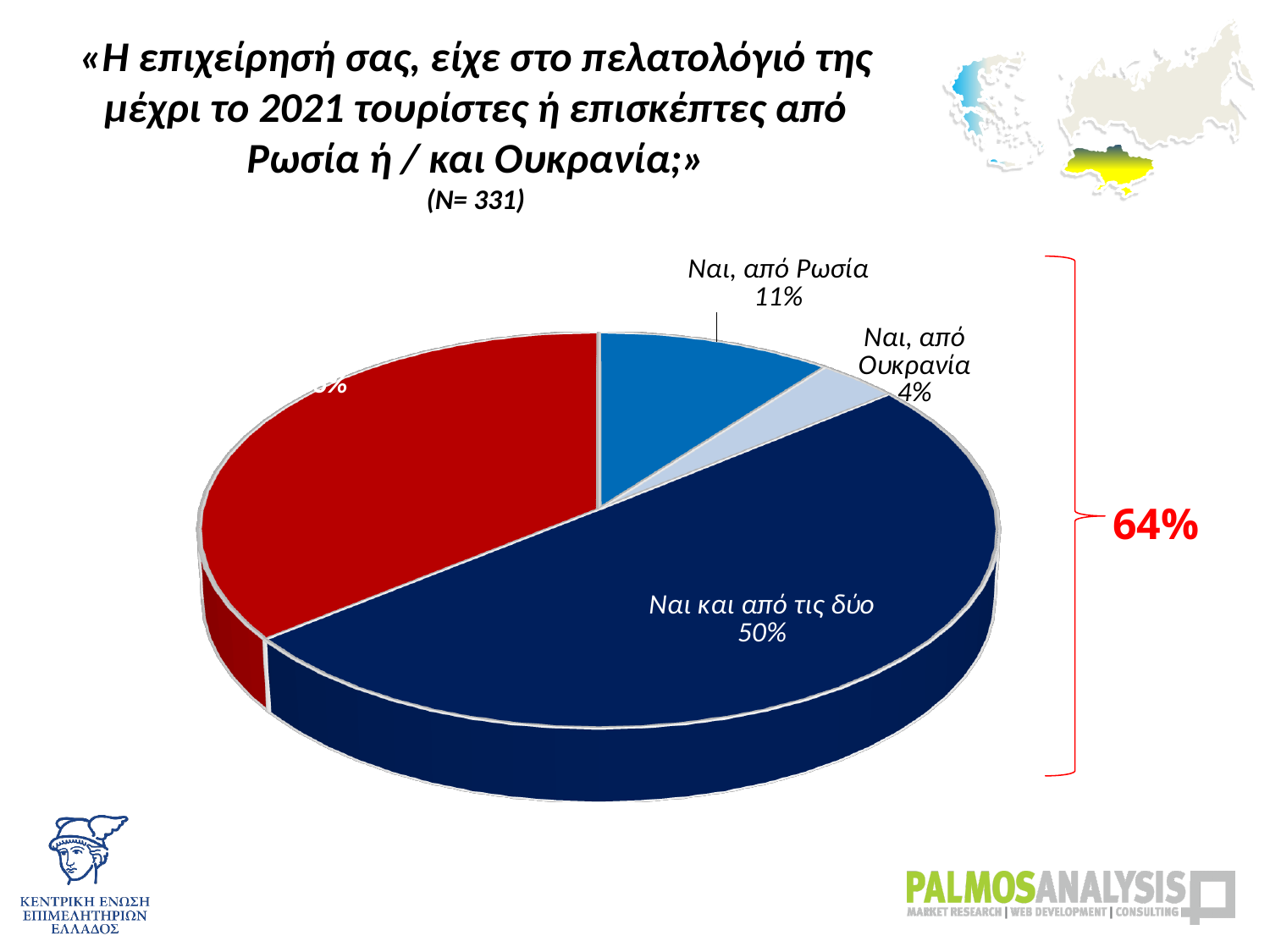
What kind of chart is shown on the slide? Pie chart What percentage of respondents answered "Ναι και από τις δύο"? 50% How many percentage points larger is "Ναι, από Ρωσία" than "Ναι, από Ουκρανία"? 7 percentage points Which slice of the pie chart is the smallest? Ναι, από Ουκρανία What is the difference in percentage points between "Ναι και από τις δύο" and "Ναι, από Ρωσία"? 39 percentage points Which is larger, the share for "Ναι, από Ρωσία" or the share for "Ναι, από Ουκρανία"? Ναι, από Ρωσία What percentage of respondents answered "Ναι, από Ρωσία"? 11% What percentage of respondents answered "Ναι, από Ουκρανία"? 4% How many slices does the pie chart have? 4 Which slice of the pie chart is the largest? Ναι και από τις δύο What combined percentage does the red bracket on the right of the chart indicate? 64% What is the sample size (N) stated under the chart title? 331